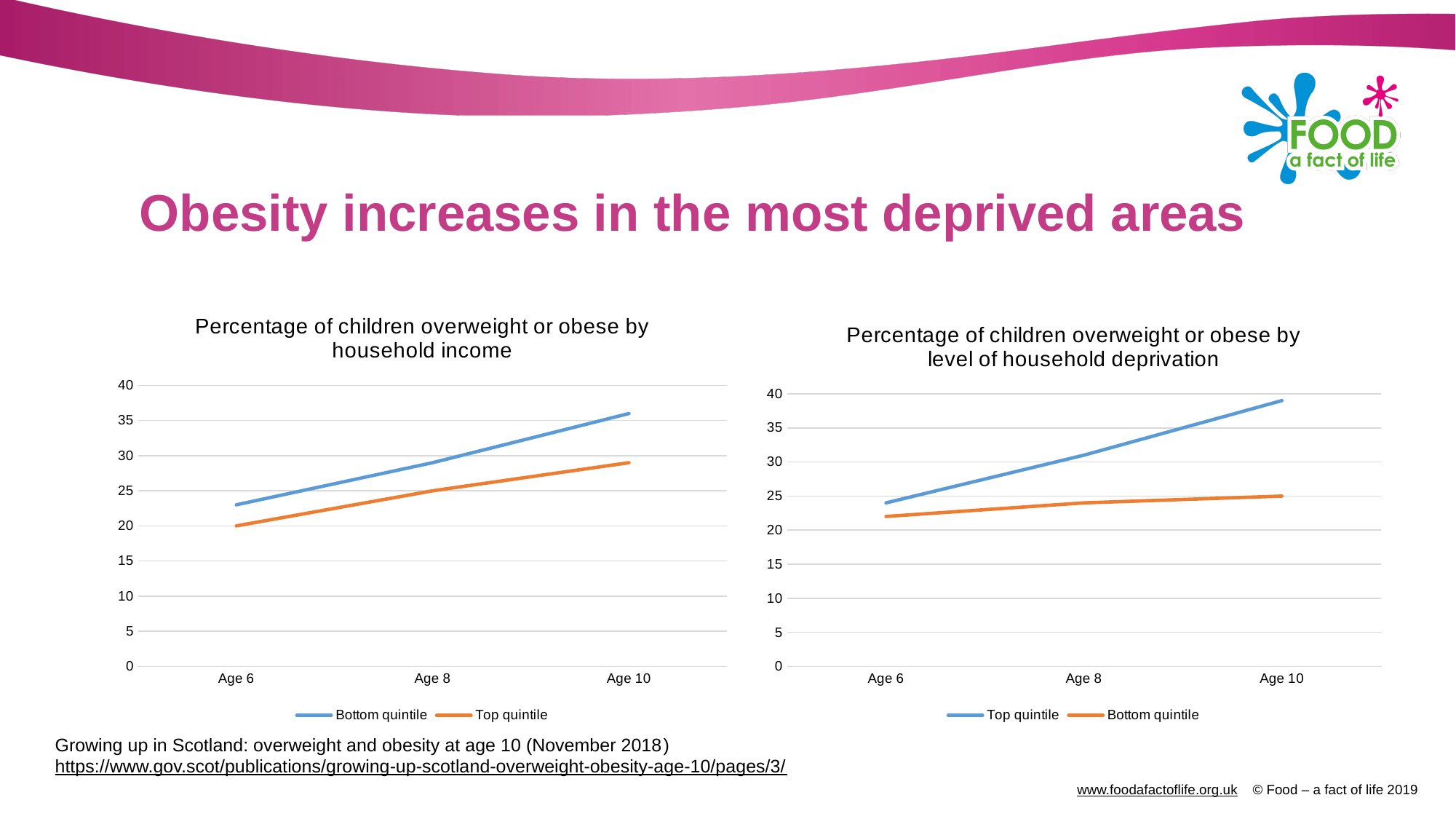
In the left chart (by household income), how many series does the legend list? 2 In the left chart (by household income), is the value for Bottom quintile at Age 6 greater or less than 20? greater In the right chart (by level of household deprivation), does the Top quintile line rise or fall from Age 6 to Age 10? rise In the left chart (by household income), is the value for Bottom quintile at Age 10 greater or less than 30? greater In the left chart (by household income), what colour is the Top quintile line? orange In the right chart (by level of household deprivation), which series has the higher value at Age 10, Top quintile or Bottom quintile? Top quintile In the right chart (by level of household deprivation), is the value for Top quintile at Age 10 greater or less than 35? greater In the right chart (by level of household deprivation), how many age categories are shown on the x axis? 3 In the left chart (by household income), which series has the higher value at Age 10, Bottom quintile or Top quintile? Bottom quintile What type of chart is the left chart, 'Percentage of children overweight or obese by household income'? line chart